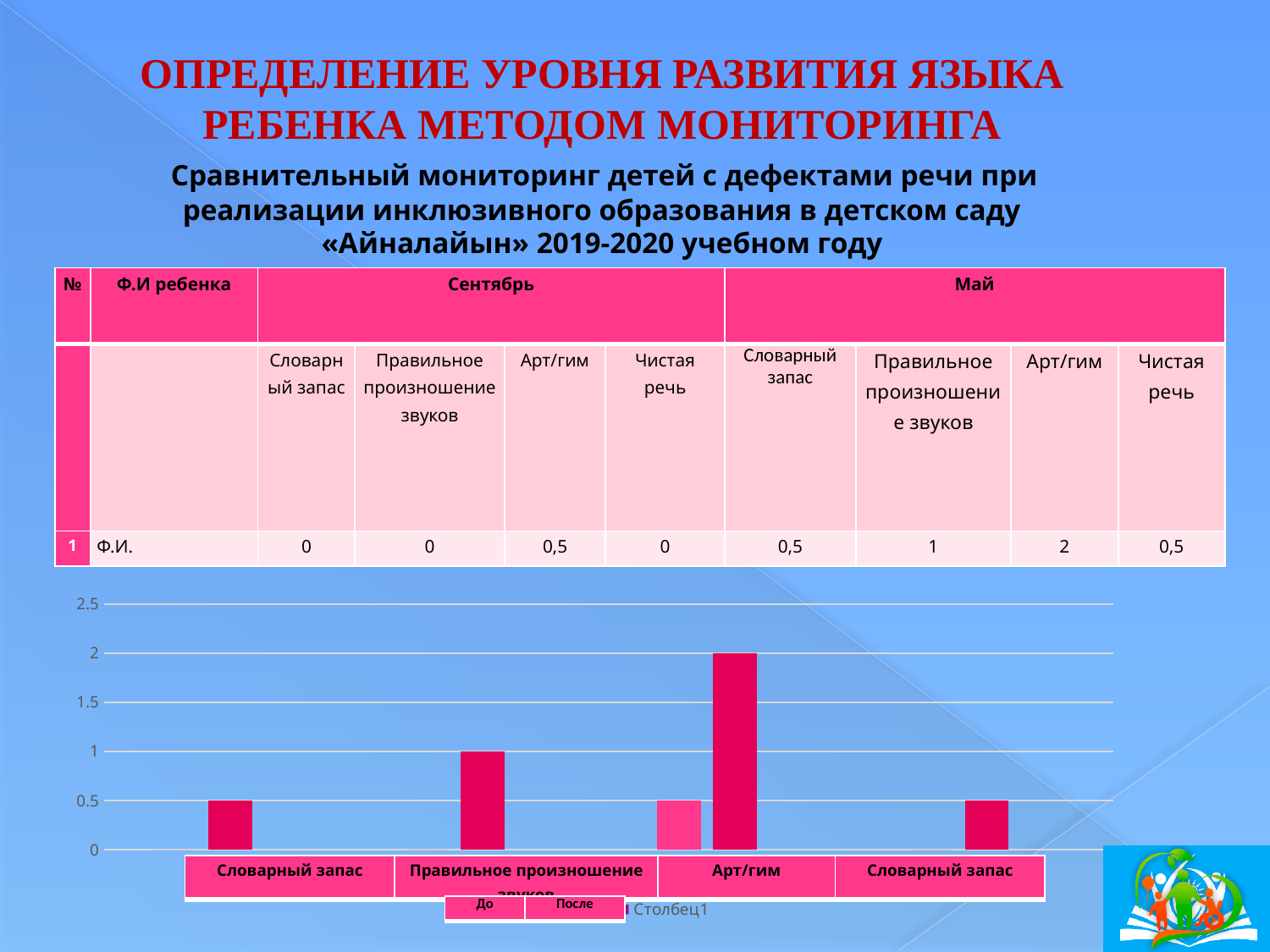
What value does the bar for Правильное произношение звуков reach in the chart? 1 Is the bar for the rightmost Словарный запас category greater or less than 1? less What is the highest value shown on the chart's y axis? 2.5 Is the tallest bar for Арт/гим greater or less than 1.5? greater How many series does the chart legend list? 3 What is the difference between the tallest bar for Арт/гим and the bar for Правильное произношение звуков? 1 Which is larger in the chart: the bar for Правильное произношение звуков or the bar for the leftmost Словарный запас? Правильное произношение звуков What value does the bar for the leftmost Словарный запас category reach in the chart? 0.5 Which category has the tallest bar in the chart? Арт/гим What value does the tallest bar for Арт/гим reach in the chart? 2 What type of chart is shown on the slide? bar chart How many categories are shown along the x axis of the chart? 4